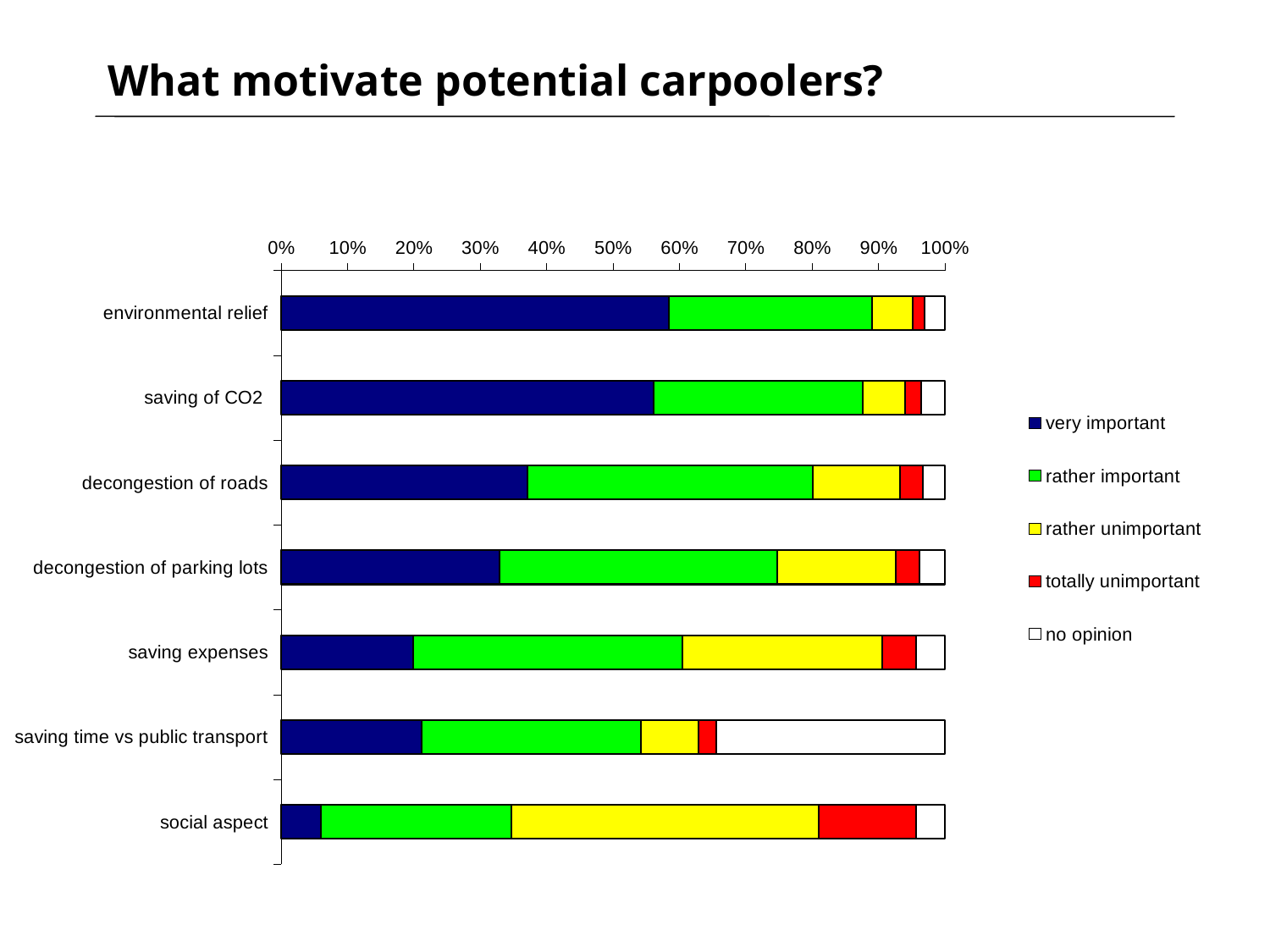
What is the title of the slide? What motivate potential carpoolers? Is the 'very important' share for social aspect greater or less than 10%? less How many motivation categories are plotted on the chart? 7 What kind of chart is shown on the slide? bar chart Is the 'very important' share for saving expenses greater or less than 30%? less Which has the larger 'very important' share: decongestion of roads or saving expenses? decongestion of roads Which category has the largest 'no opinion' share? saving time vs public transport How many series does the legend list? 5 Which category has the smallest 'very important' share? social aspect Is the 'very important' share for environmental relief greater or less than 50%? greater Which has the larger 'rather unimportant' share: social aspect or environmental relief? social aspect Which category has the largest 'totally unimportant' share? social aspect